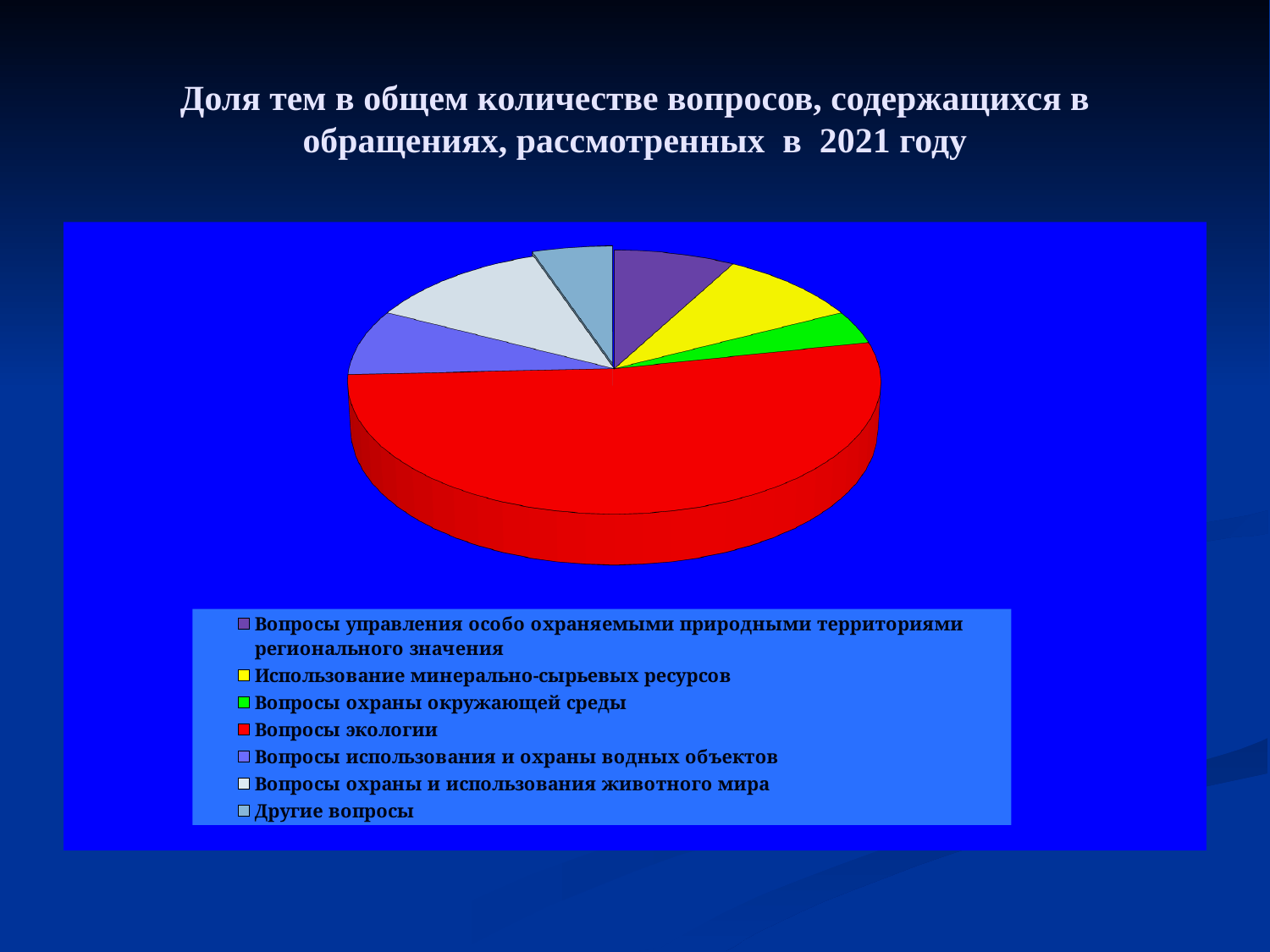
Which has the larger share: Вопросы управления особо охраняемыми природными территориями регионального значения or Вопросы охраны окружающей среды? Вопросы управления особо охраняемыми природными территориями регионального значения Which has the larger share: Использование минерально-сырьевых ресурсов or Вопросы охраны окружающей среды? Использование минерально-сырьевых ресурсов Which has the larger share: Вопросы охраны и использования животного мира or Другие вопросы? Вопросы охраны и использования животного мира Which category has the smallest share of the pie? Вопросы охраны окружающей среды What colour is the slice for Вопросы экологии? red How many slices does the pie chart have? 7 Which category has the largest share of the pie? Вопросы экологии What is the title of the slide? Доля тем в общем количестве вопросов, содержащихся в обращениях, рассмотренных в 2021 году What kind of chart is shown on the slide? pie chart